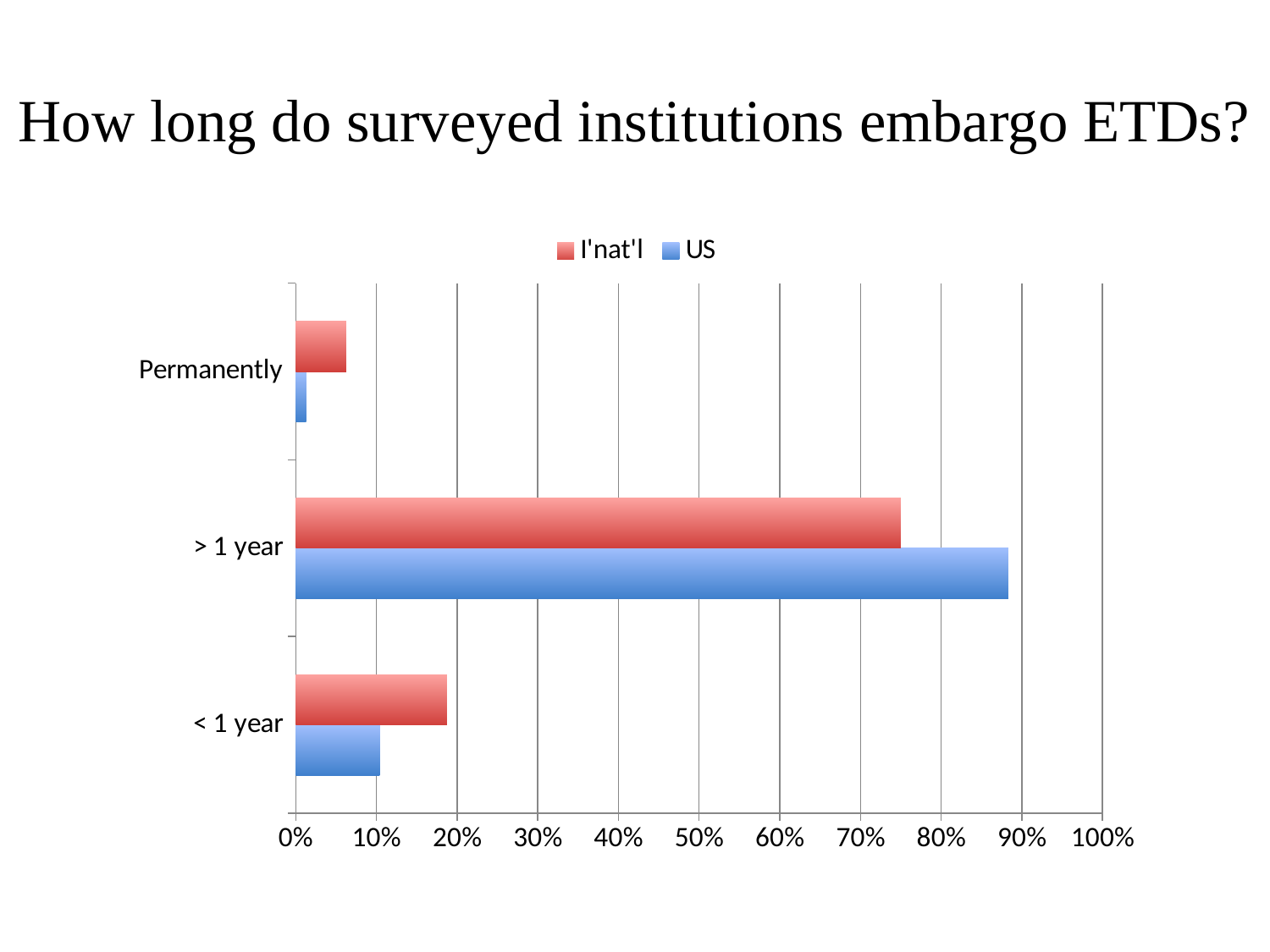
For the < 1 year category, which series has the larger value, I'nat'l or US? I'nat'l Is the I'nat'l value for < 1 year greater or less than 30%? less What colour are the bars for the US series? blue How many series does the legend list? 2 Which category has the highest value for the I'nat'l series? > 1 year What kind of chart is shown on the slide? bar chart For the > 1 year category, which series has the larger value, I'nat'l or US? US Which category has the highest value for the US series? > 1 year How many categories are shown on the chart? 3 Which category has the lowest value for the US series? Permanently Is the US value for > 1 year greater or less than 80%? greater Which category has the lowest value for the I'nat'l series? Permanently